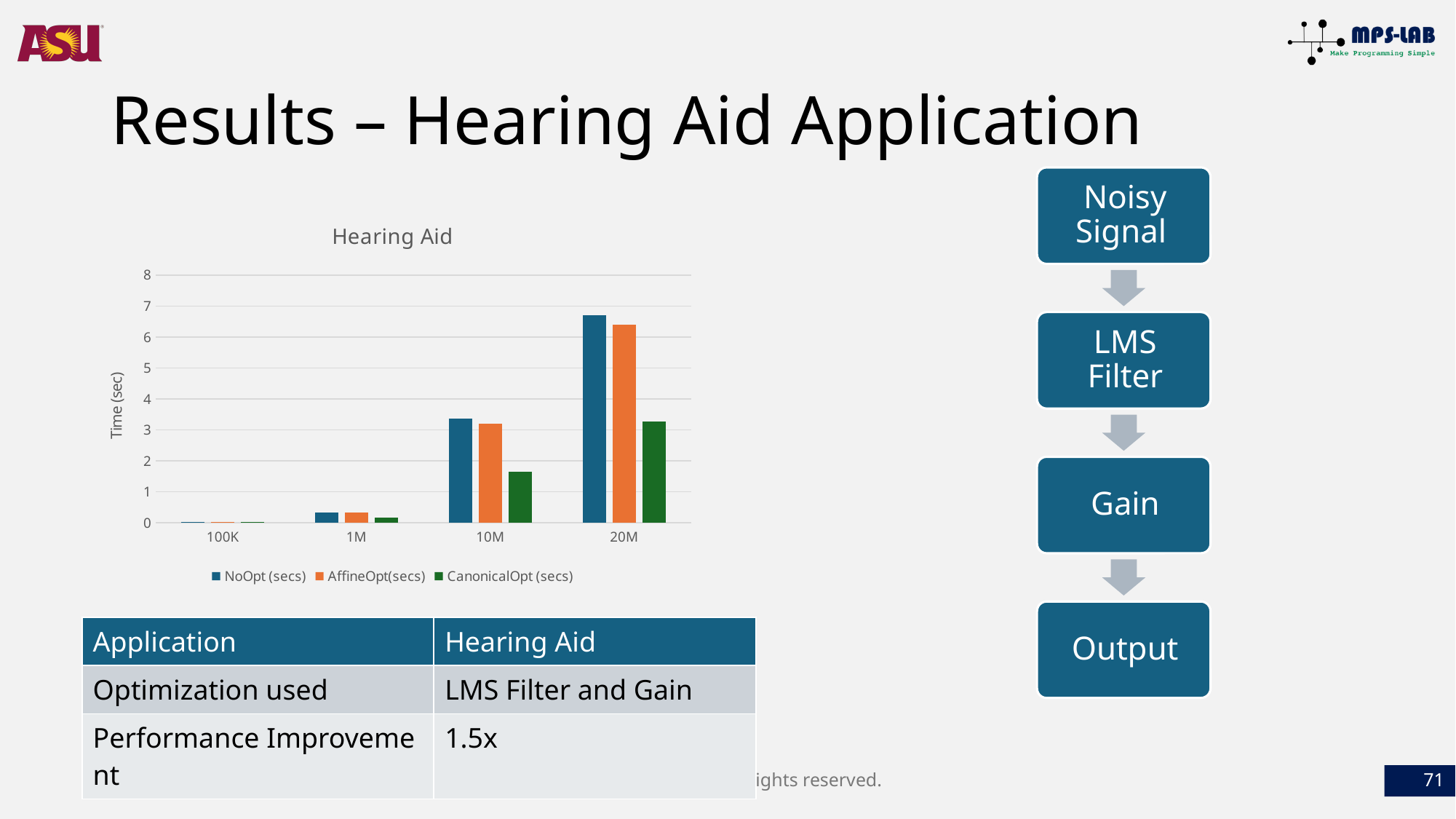
Is the NoOpt (secs) value for 20M greater or less than 6? greater Which category has the highest NoOpt (secs) value? 20M At 20M, which is larger: NoOpt (secs) or CanonicalOpt (secs)? NoOpt (secs) How many categories are shown on the x axis of the Hearing Aid chart? 4 What is the title of the chart? Hearing Aid Is the CanonicalOpt (secs) value for 10M greater or less than 2? less Do the NoOpt (secs) values rise or fall from 100K to 20M along the x axis? rise What is the label on the y axis of the chart? Time (sec) Is the CanonicalOpt (secs) value for 20M greater or less than 4? less How many series does the legend of the Hearing Aid chart list? 3 Which series has the lowest value at 20M? CanonicalOpt (secs) What kind of chart is shown on the slide? bar chart